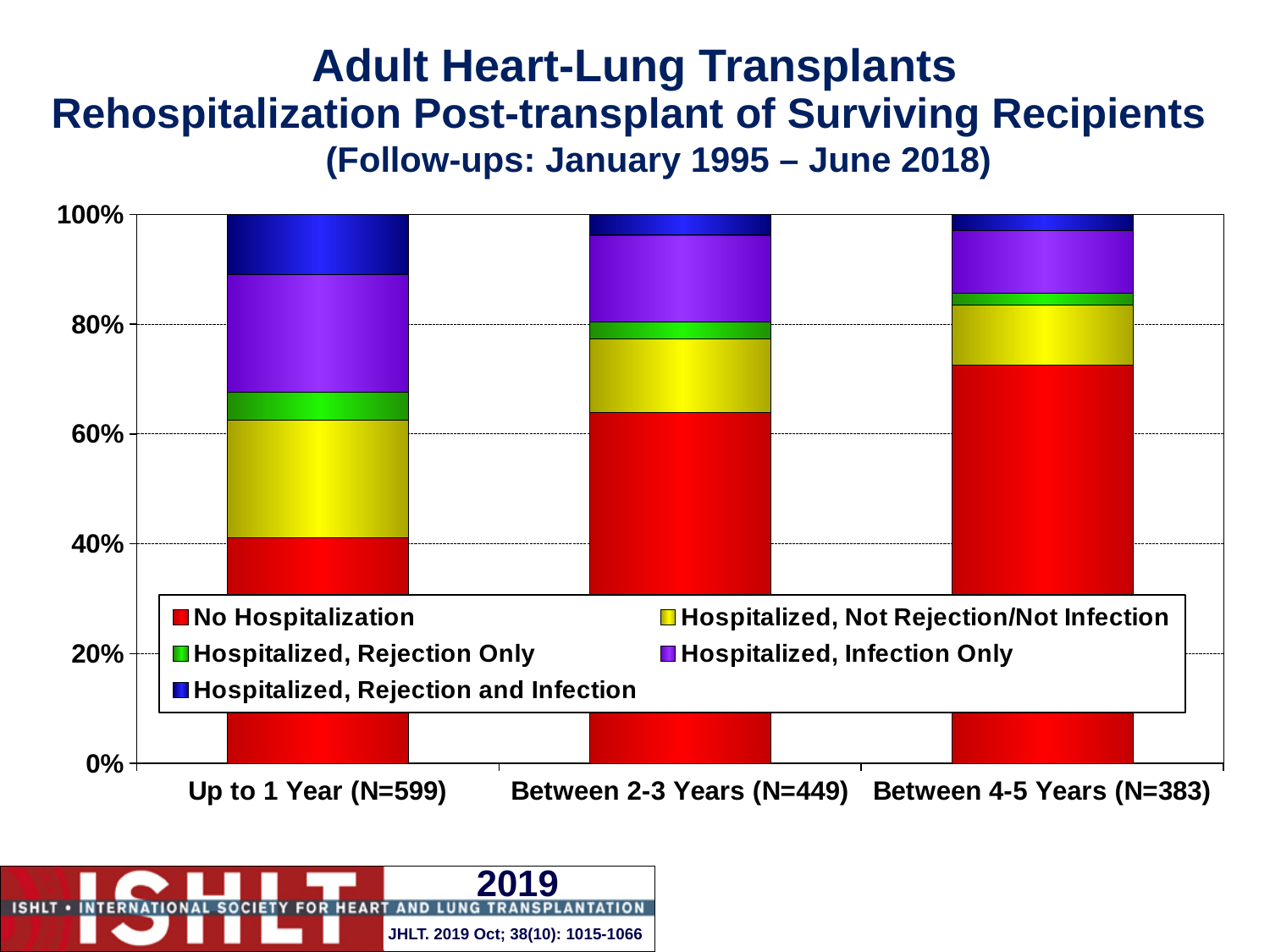
What kind of chart is shown on the slide? Stacked bar chart Is the No Hospitalization share for Up to 1 Year (N=599) greater or less than 60%? less Which follow-up period has the highest share of No Hospitalization? Between 4-5 Years (N=383) What is the total of each stacked bar? 100% Which is larger, the No Hospitalization share for Up to 1 Year (N=599) or for Between 2-3 Years (N=449)? Between 2-3 Years (N=449) Is the No Hospitalization share for Between 4-5 Years (N=383) greater or less than 80%? less Is the No Hospitalization share for Between 2-3 Years (N=449) greater or less than 60%? greater Does the No Hospitalization share rise or fall across the follow-up periods from left to right? Rise How many categories (follow-up periods) are shown on the x axis? 3 How many series does the legend list? 5 Which follow-up period has the lowest share of No Hospitalization? Up to 1 Year (N=599) What colour represents No Hospitalization in the legend? Red